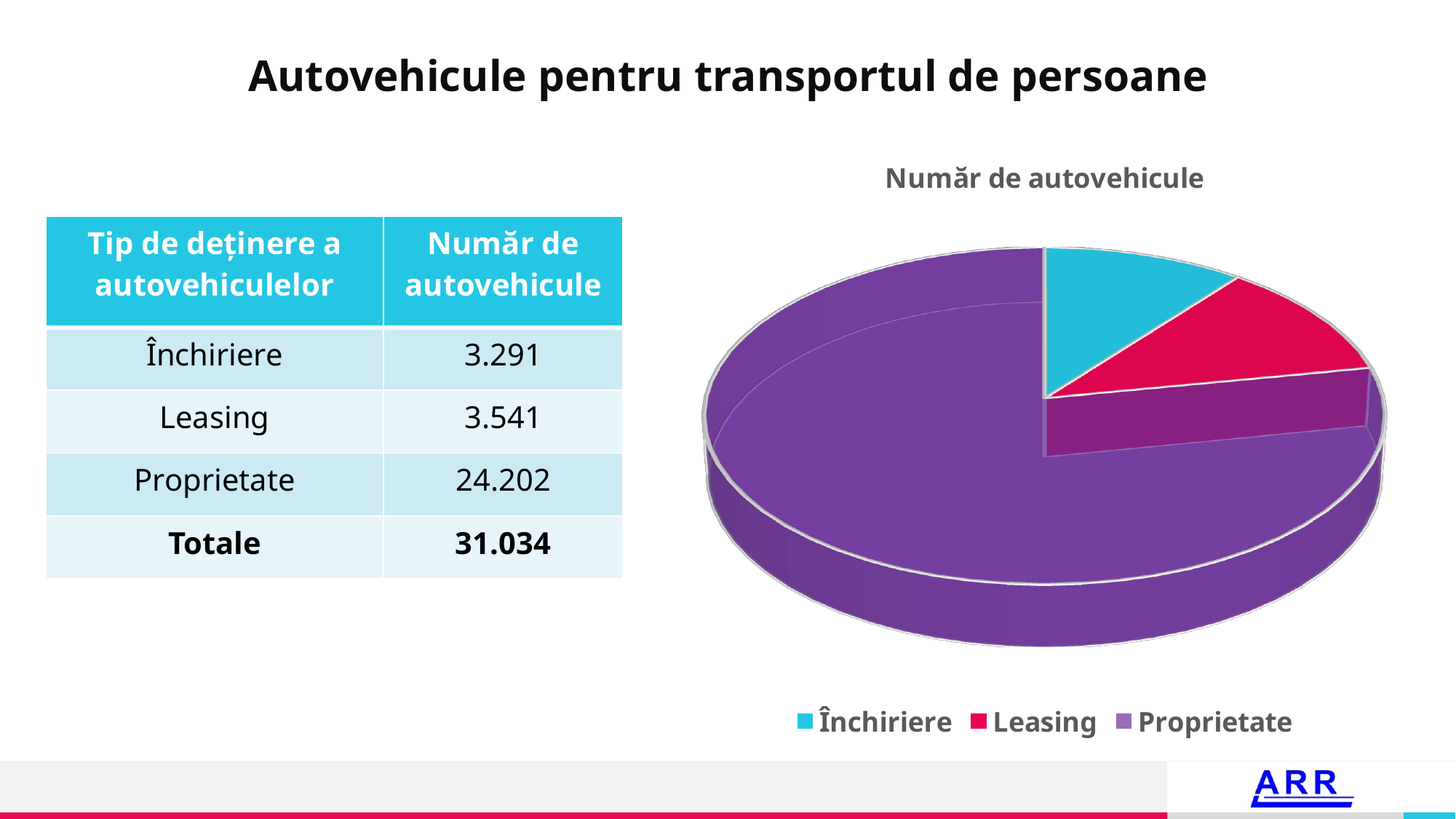
What is the number of vehicles for Închiriere? 3.291 What is the number of vehicles for Proprietate? 24.202 How many slices does the pie chart have? 3 What kind of chart is shown on the slide? pie chart What is the difference between the Leasing and Închiriere values? 250 Which category has the largest slice in the pie chart? Proprietate Which category has the smallest number of vehicles? Închiriere How many entries does the legend of the pie chart list? 3 Which is larger, the value for Leasing or the value for Închiriere? Leasing What is the number of vehicles for Leasing? 3.541 What is the title of the pie chart? Număr de autovehicule What colour is the Proprietate slice in the pie chart? purple